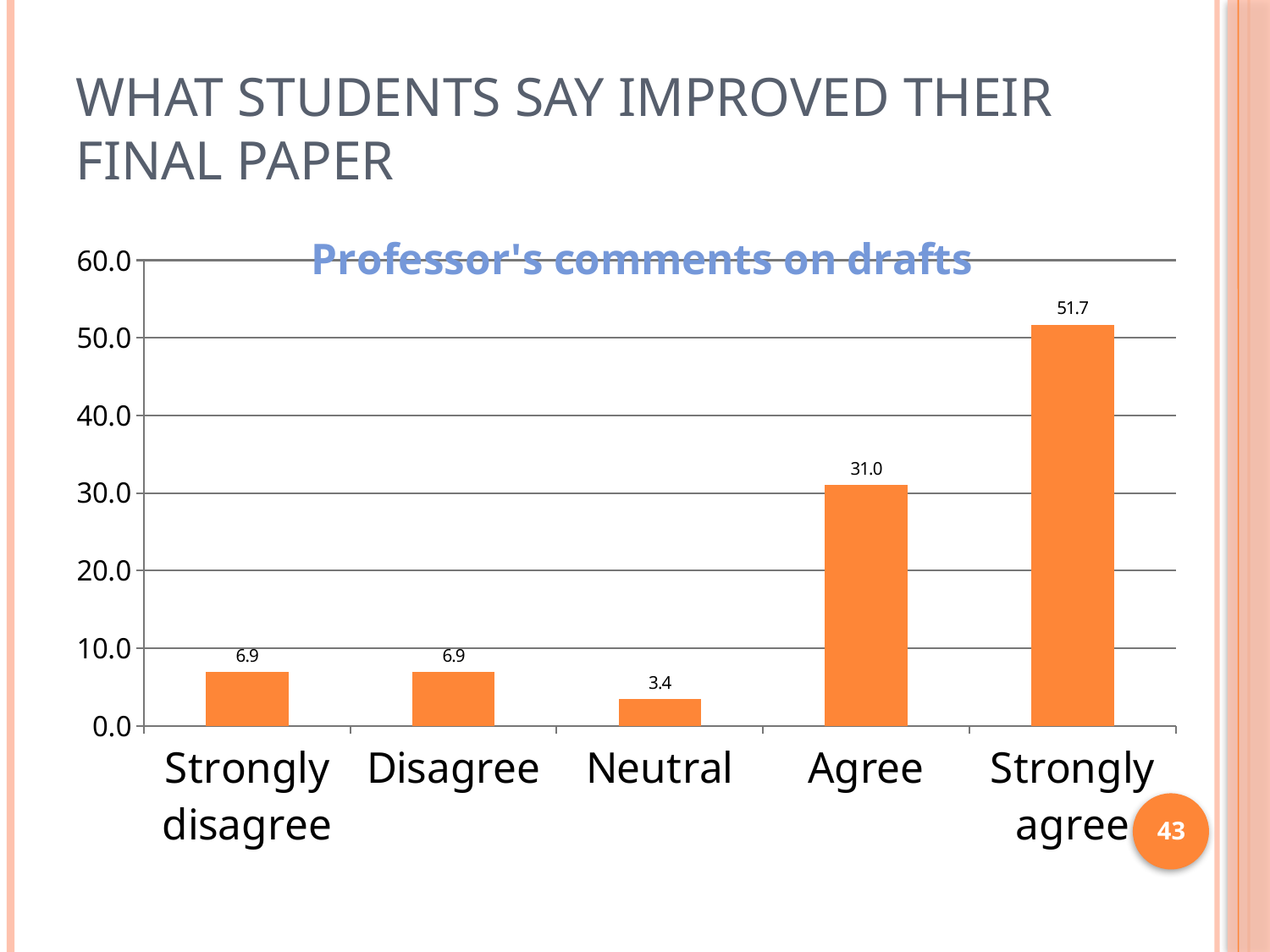
What is the value for Strongly disagree? 6.9 Which is larger, the value for Agree or the value for Disagree? Agree Which category has the lowest value? Neutral What is the difference between the values for Strongly agree and Agree? 20.7 What is the value for Neutral? 3.4 What is the value for Strongly agree? 51.7 What is the difference between the values for Disagree and Neutral? 3.5 What kind of chart is shown on the slide? Bar chart Which category has the highest value? Strongly agree What is the value for Agree? 31.0 What is the title of the chart? Professor's comments on drafts How many categories are shown on the x axis? 5